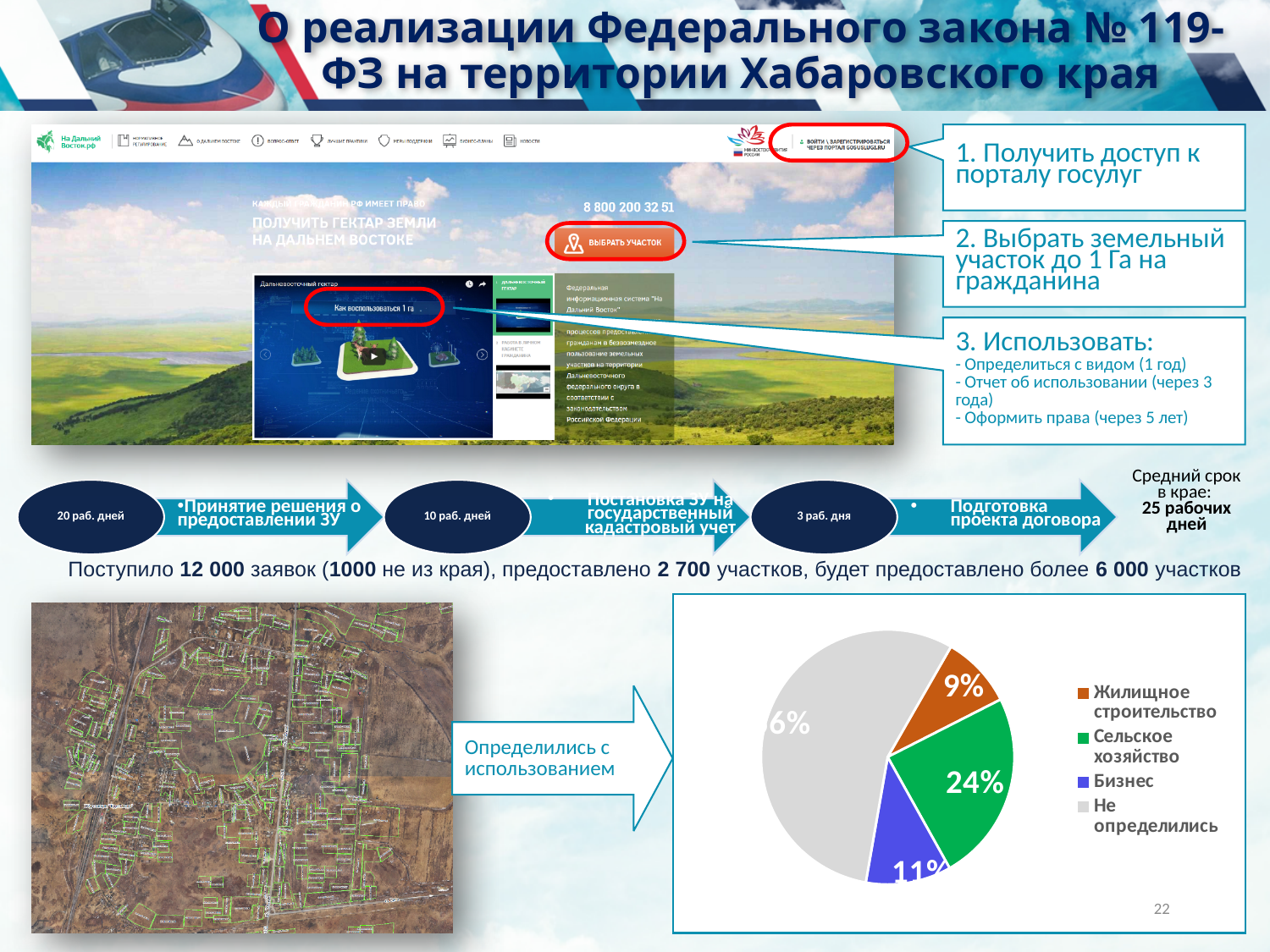
In the pie chart, what is the difference between the shares of Сельское хозяйство and Бизнес? 13% Which category has the smallest slice in the pie chart? Жилищное строительство What colour is the Бизнес slice in the pie chart? Blue What kind of chart is shown at the bottom right of the slide? Pie chart In the pie chart, what share is labelled for Жилищное строительство? 9% In the pie chart, what share is labelled for Сельское хозяйство? 24% In the pie chart, what is the difference between the shares of Бизнес and Жилищное строительство? 2% Which category has the largest slice in the pie chart? Не определились How many categories does the legend of the pie chart list? 4 What colour is the Сельское хозяйство slice in the pie chart? Green In the pie chart, which is larger: Сельское хозяйство or Бизнес? Сельское хозяйство In the pie chart, what share is labelled for Бизнес? 11%